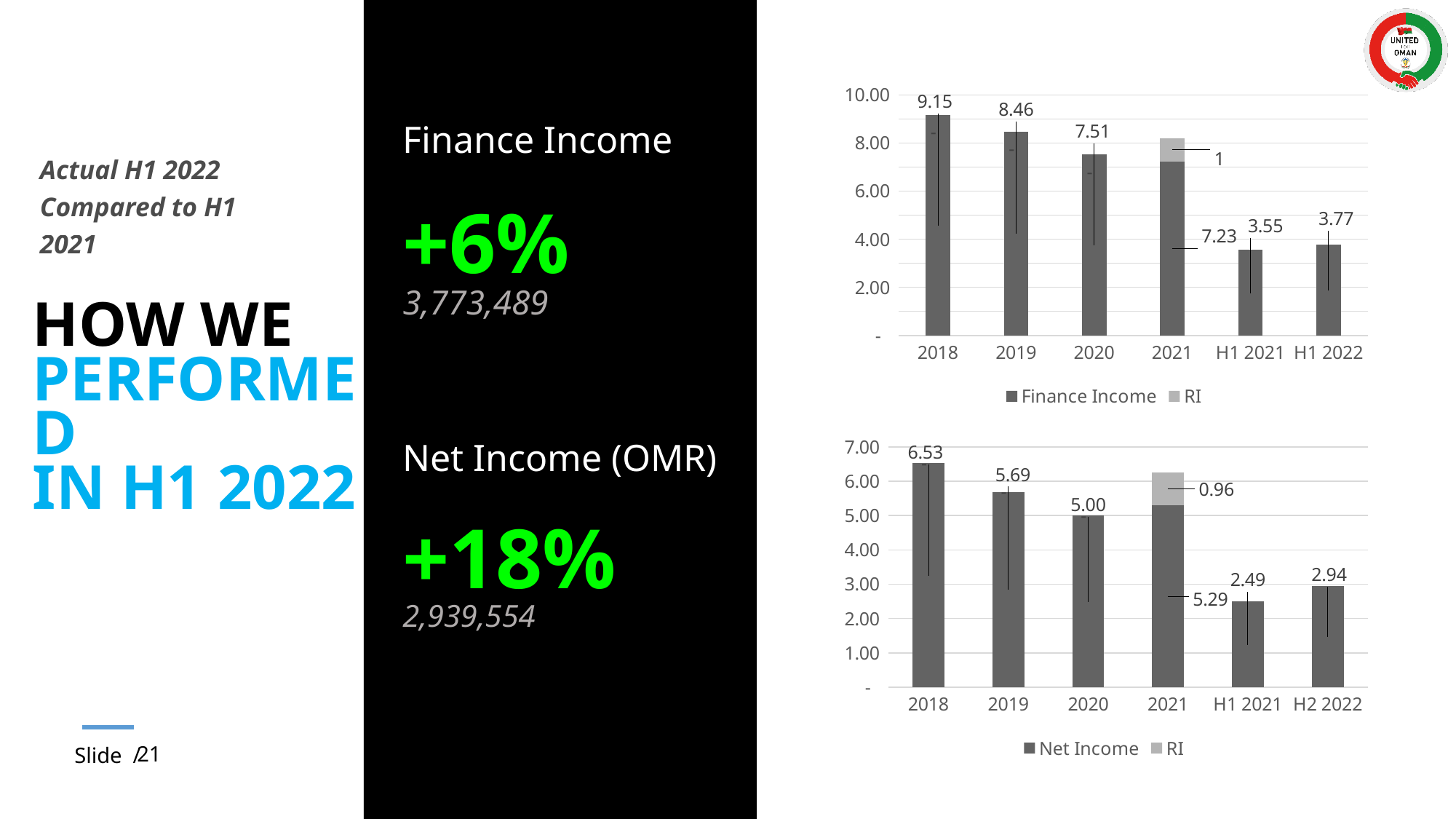
In the bottom chart, is the Net Income value for H2 2022 larger or smaller than the value for H1 2021? larger In the top chart, how many series does the legend list? 2 In the top chart, what is the RI value for 2021? 1 In the top chart, what is the Finance Income value for H1 2022? 3.77 In the top chart, what is the Finance Income value for 2018? 9.15 In the bottom chart, what is the RI value for 2021? 0.96 What kind of chart is the bottom chart? bar chart In the top chart, which category has the highest Finance Income value? 2018 In the bottom chart, what is the Net Income value for 2020? 5.00 In the bottom chart, which category has the lowest Net Income value? H1 2021 In the top chart, what is the difference between the Finance Income values for H1 2022 and H1 2021? 0.22